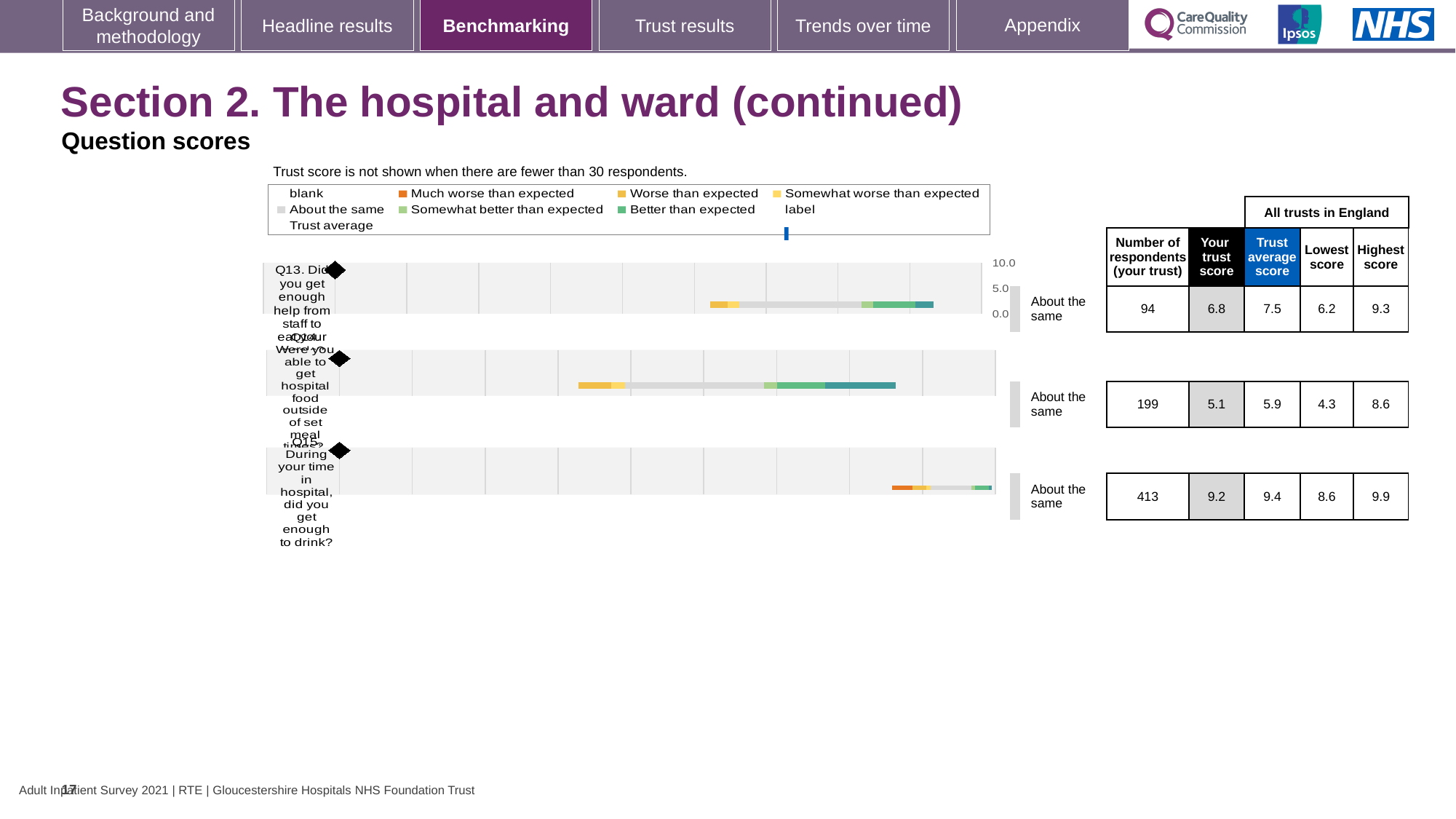
What kind of chart is used to show the question scores on this slide? bar chart How many respondents answered Q15 for this trust? 413 What is the trust score for Q13 (Did you get enough help from staff to eat your meals?)? 6.8 What is the difference between the trust score for Q15 and the trust score for Q13? 2.4 Which of the three questions has the lowest trust score? Q14 What is the trust score for Q14 (Were you able to get hospital food outside of set meal times?)? 5.1 Which of the three questions has the highest trust score? Q15 What benchmark category is shown for all three questions on this slide? About the same What is the trust score for Q15 (During your time in hospital, did you get enough to drink?)? 9.2 How many questions (categories) are plotted in the chart? 3 What is the trust average score across all trusts in England for Q14? 5.9 For Q13, which is larger: the trust's own score or the trust average score for all trusts in England? Trust average score (7.5)